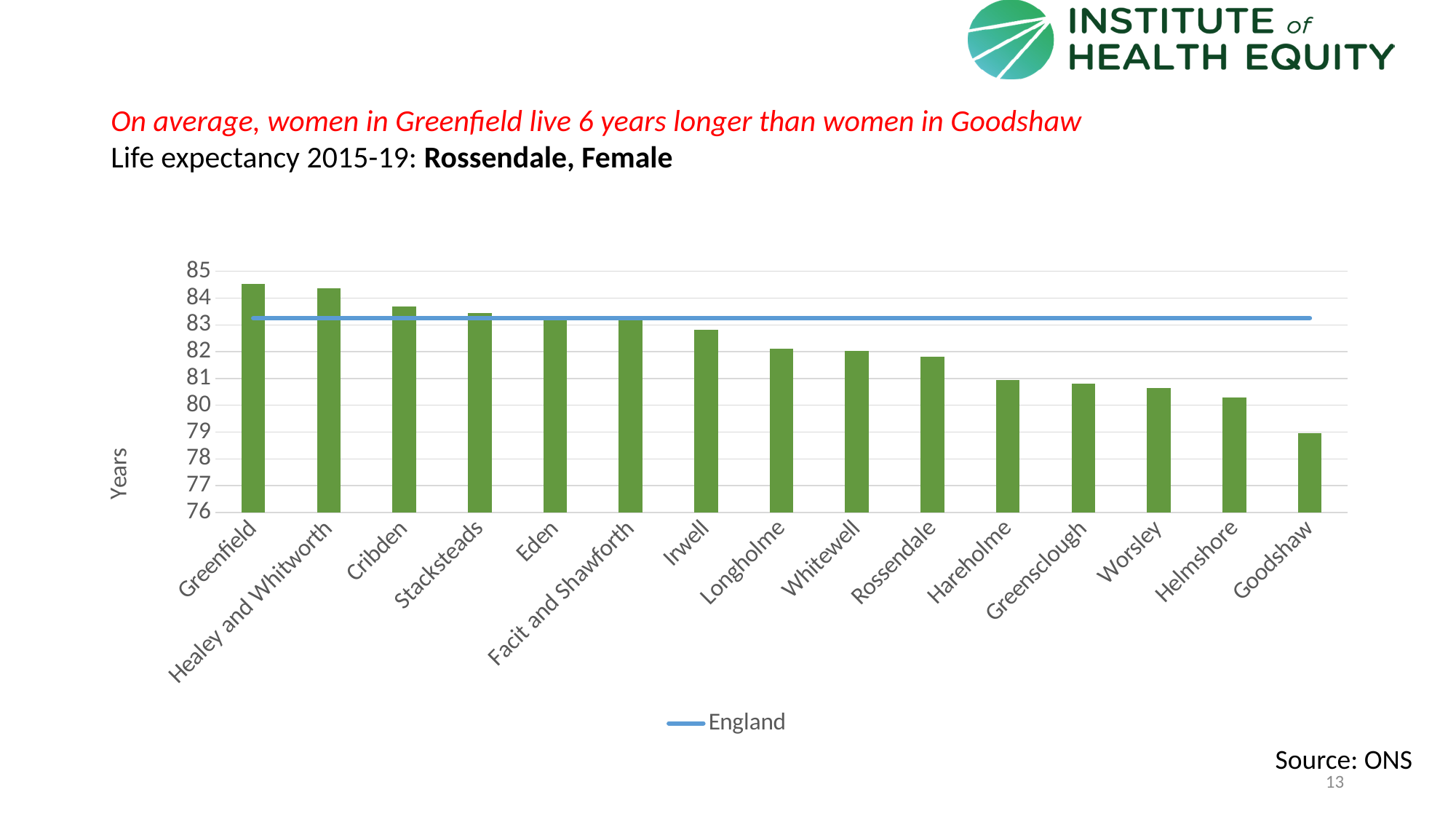
How many areas are shown on the x axis of the chart? 15 What label is shown on the chart's y axis? Years How many series does the chart's legend list? 1 Is the value for Cribden greater or less than 83? greater Is the value for Worsley greater or less than 81? less Do the bar values rise or fall from left to right along the x axis? Fall Is the value for Goodshaw greater or less than 80? less What kind of chart is shown on the slide? Combination bar and line chart Which area has the highest female life expectancy in the chart? Greenfield Which has the larger value, Cribden or Whitewell? Cribden Which area has the lowest female life expectancy in the chart? Goodshaw